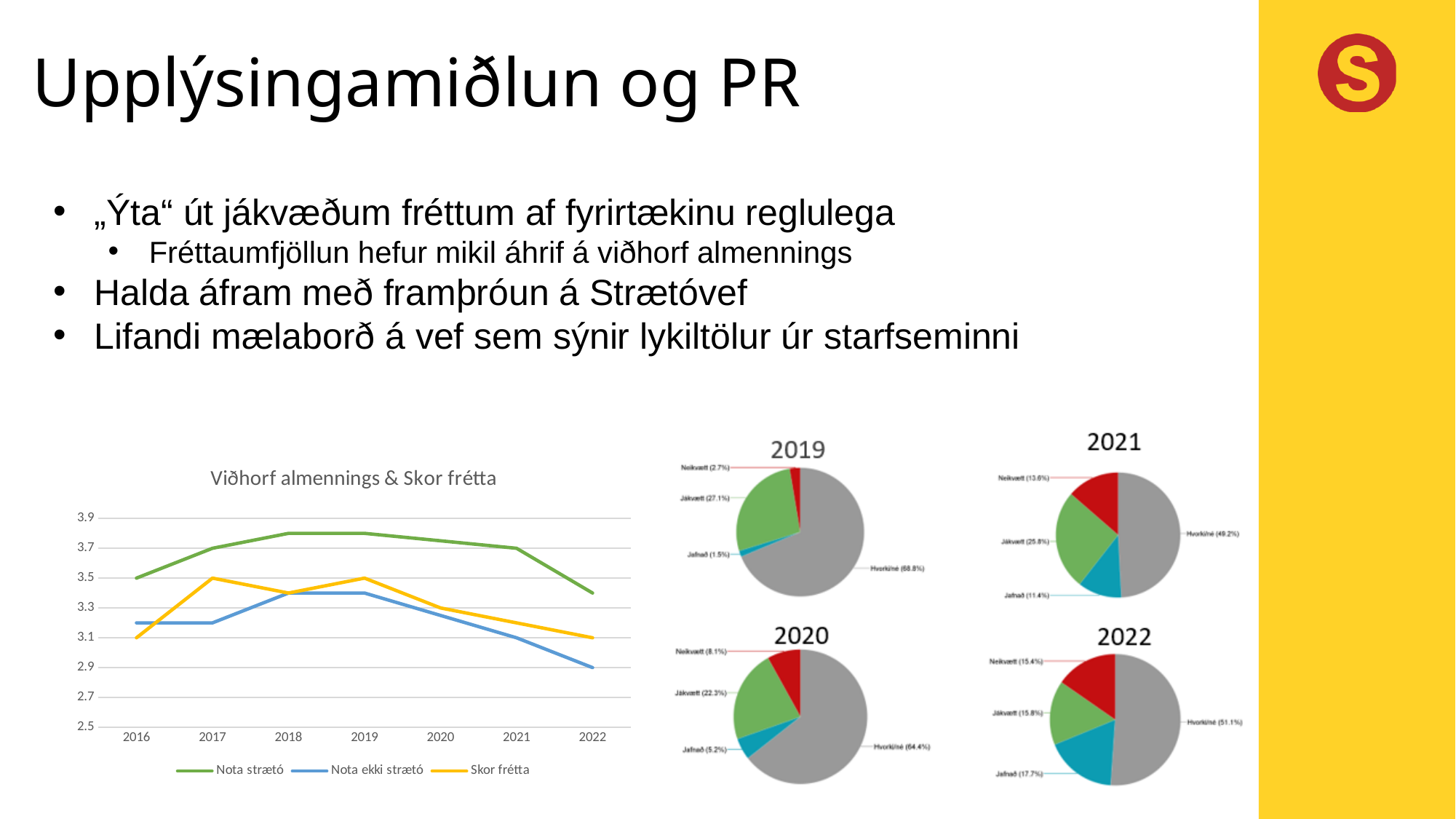
In the line chart "Viðhorf almennings & Skor frétta", what is the value of Nota ekki strætó in 2022? 2.9 In the line chart "Viðhorf almennings & Skor frétta", what is the value of Skor frétta in 2017? 3.5 In the line chart "Viðhorf almennings & Skor frétta", how many years are shown on the x axis? 7 In the line chart "Viðhorf almennings & Skor frétta", does the Nota ekki strætó series rise or fall from 2019 to 2022? fall In the 2022 pie chart, what share is Jafnað? 17.7% In the 2021 pie chart, which is larger, Jákvætt or Neikvætt? Jákvætt In the line chart "Viðhorf almennings & Skor frétta", which series has the highest value in 2022? Nota strætó In the 2019 pie chart, what share is Hvorki/né? 68.8% In the line chart "Viðhorf almennings & Skor frétta", is the value of Nota strætó in 2019 greater or less than 3.7? greater In the line chart "Viðhorf almennings & Skor frétta", how many series does the legend list? 3 In the line chart "Viðhorf almennings & Skor frétta", what is the value of Nota strætó in 2016? 3.5 What kind of chart is "Viðhorf almennings & Skor frétta"? line chart